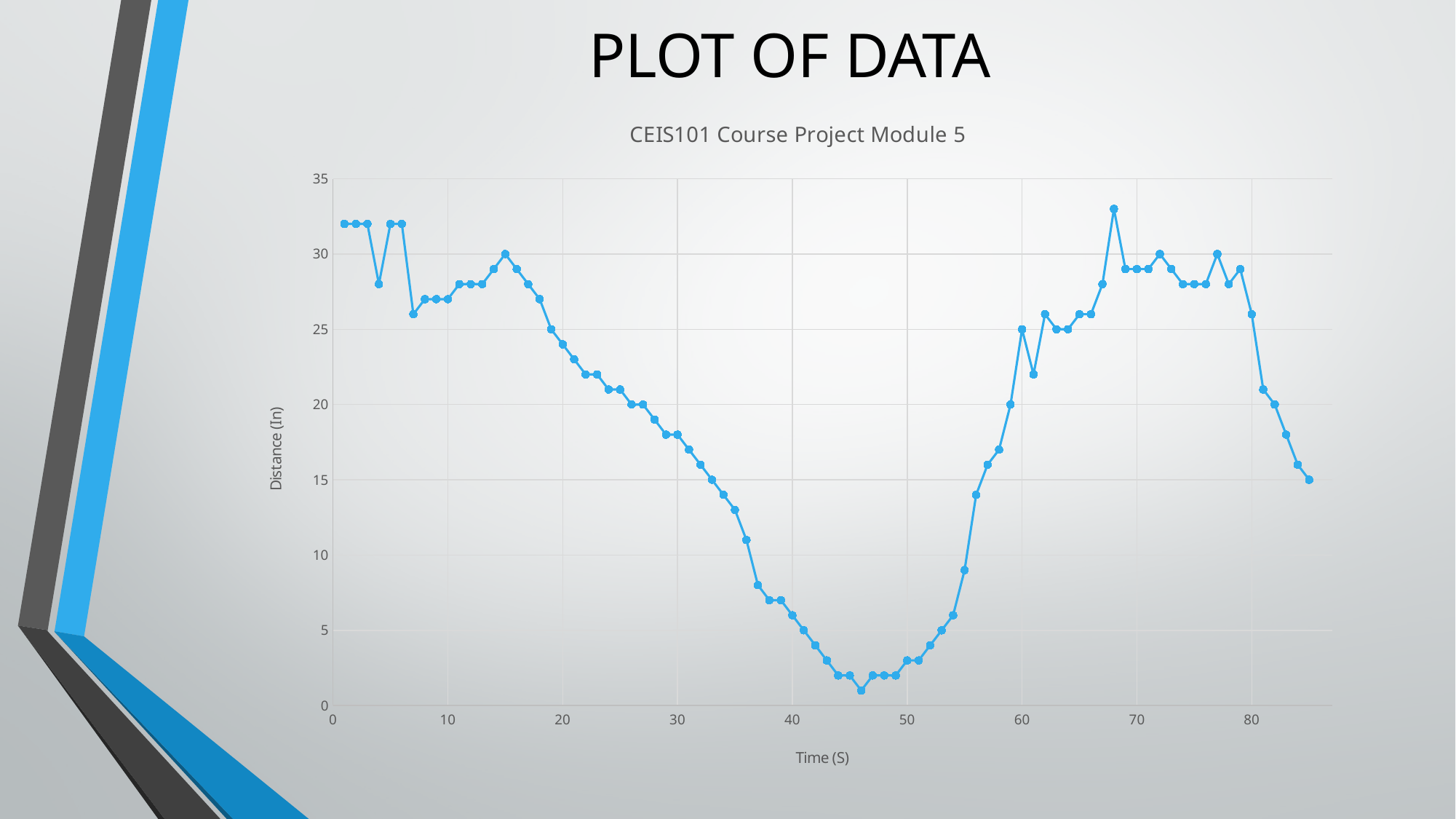
Is the highest distance value on the chart greater or less than 30? greater What is the label of the vertical axis? Distance (In) Which is larger, the distance at time 10 or the distance at time 50? time 10 Is the distance at time 80 greater or less than 30? less What is the title of the chart? CEIS101 Course Project Module 5 Is the distance at time 50 greater or less than 5? less What kind of chart is shown on the slide? line chart Between time 20 and time 40, do the distance values rise or fall? fall